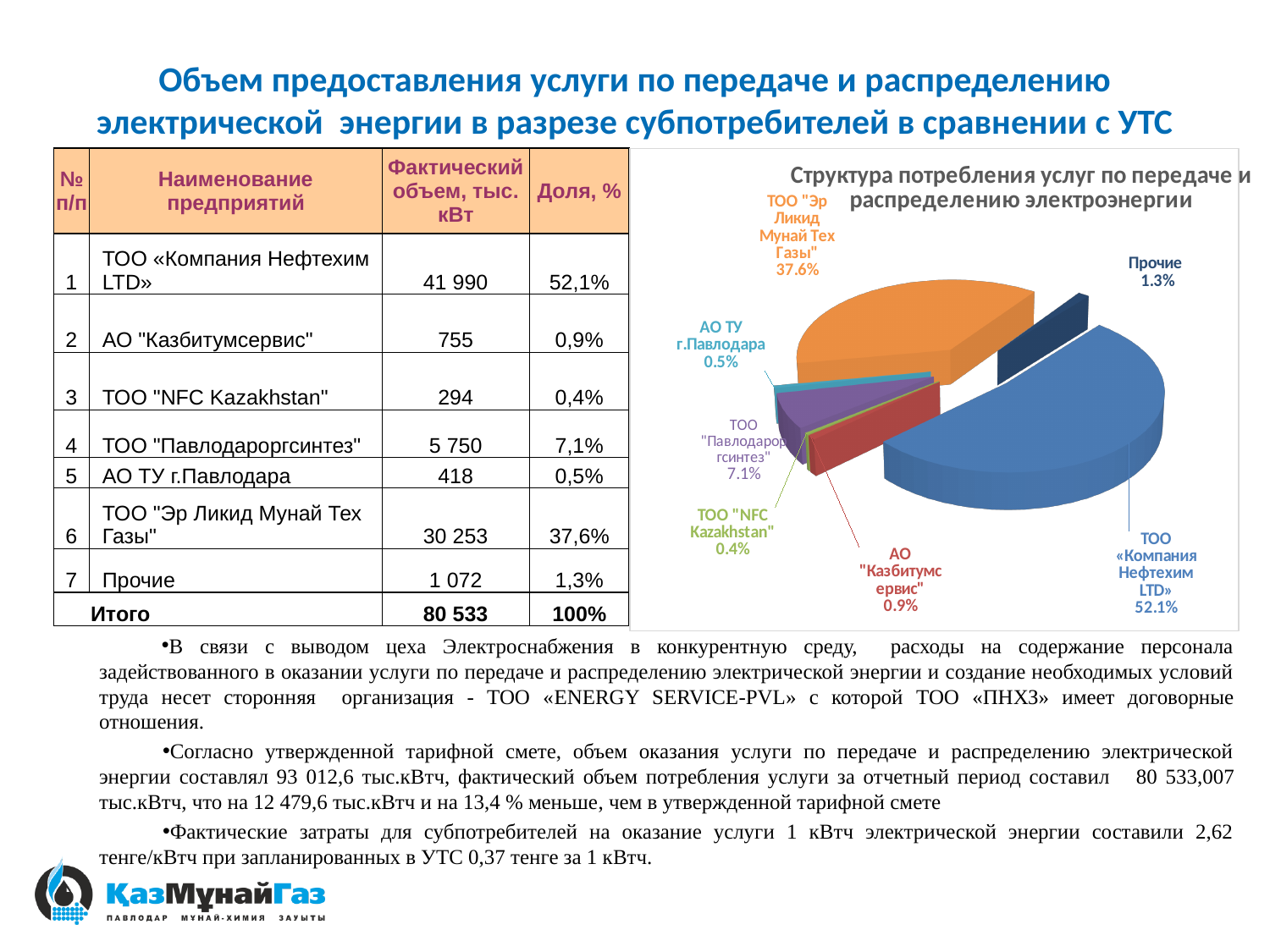
What is the value shown for ТОО "Павлодароргсинтез" in the pie chart? 7.1% Which category has the largest slice of the pie? ТОО «Компания Нефтехим LTD» What share of the pie does ТОО «Компания Нефтехим LTD» have? 52.1% How many slices does the pie chart have? 7 What is the value shown for АО ТУ г.Павлодара in the pie chart? 0.5% Which category has the smallest slice of the pie? ТОО "NFC Kazakhstan" What share of the pie does ТОО "Эр Ликид Мунай Тех Газы" have? 37.6% Which is larger in the pie chart: АО "Казбитумсервис" or АО ТУ г.Павлодара? АО "Казбитумсервис" What is the value shown for Прочие in the pie chart? 1.3% What is the title of the pie chart? Структура потребления услуг по передаче и распределению электроэнергии What is the difference in percentage points between ТОО «Компания Нефтехим LTD» and ТОО "Эр Ликид Мунай Тех Газы" in the pie chart? 14.5% What kind of chart is shown on the slide? pie chart